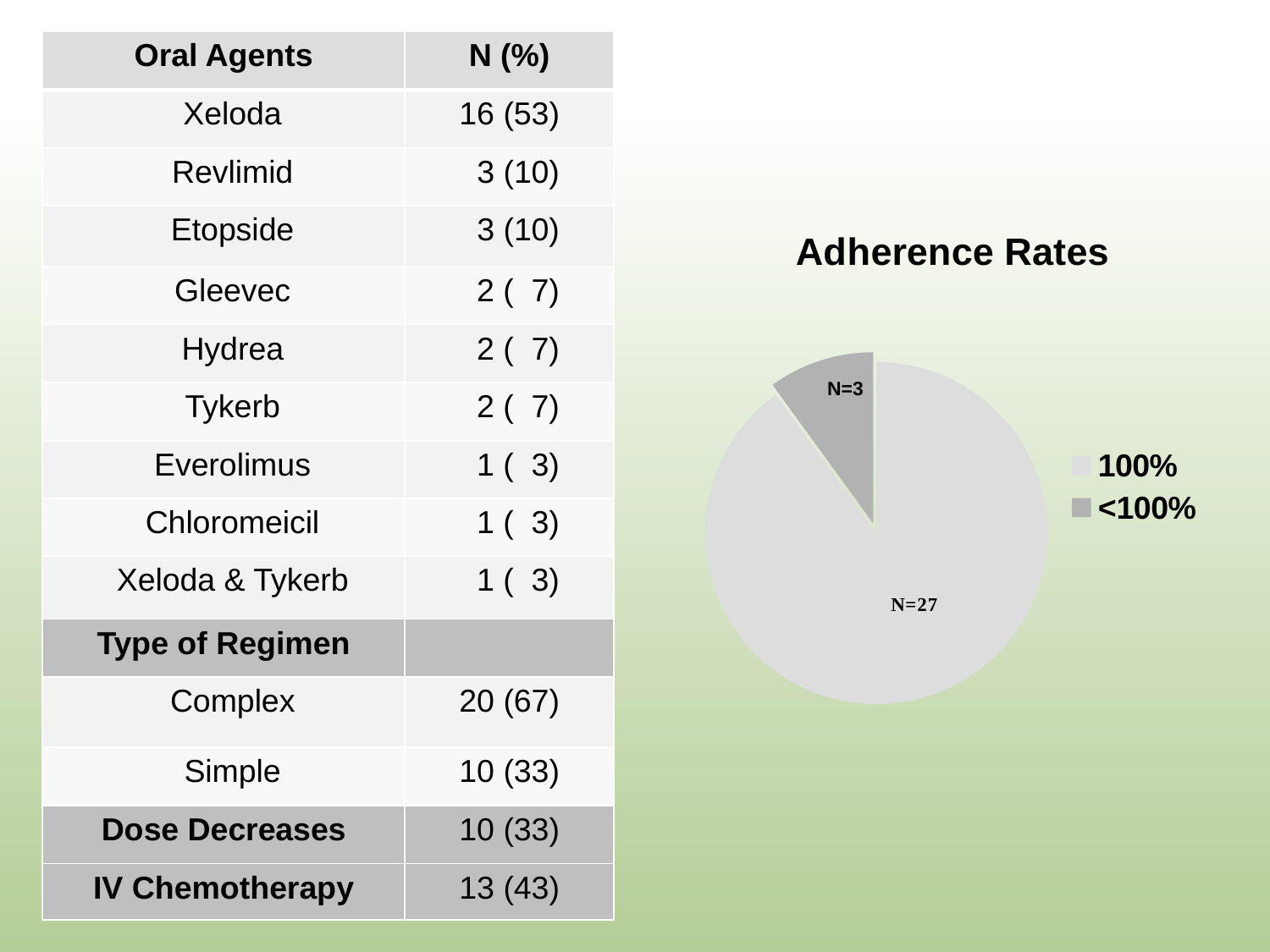
What type of chart is shown under the title "Adherence Rates"? pie chart In the Adherence Rates pie chart, what is the data label on the 100% slice? N=27 Which slice of the Adherence Rates pie chart is the smallest? <100% In the Adherence Rates pie chart, what is the data label on the <100% slice? N=3 How many slices does the Adherence Rates pie chart have? 2 Which slice of the Adherence Rates pie chart is the largest? 100% What is the title of the pie chart? Adherence Rates What share of the Adherence Rates pie does the <100% slice represent? 10% In the Adherence Rates pie chart, which slice has the larger value, 100% or <100%? 100% How many entries does the legend of the Adherence Rates pie chart list? 2 What is the total number of patients represented in the Adherence Rates pie chart? 30 In the Adherence Rates pie chart, how many more patients are in the 100% slice than in the <100% slice? 24